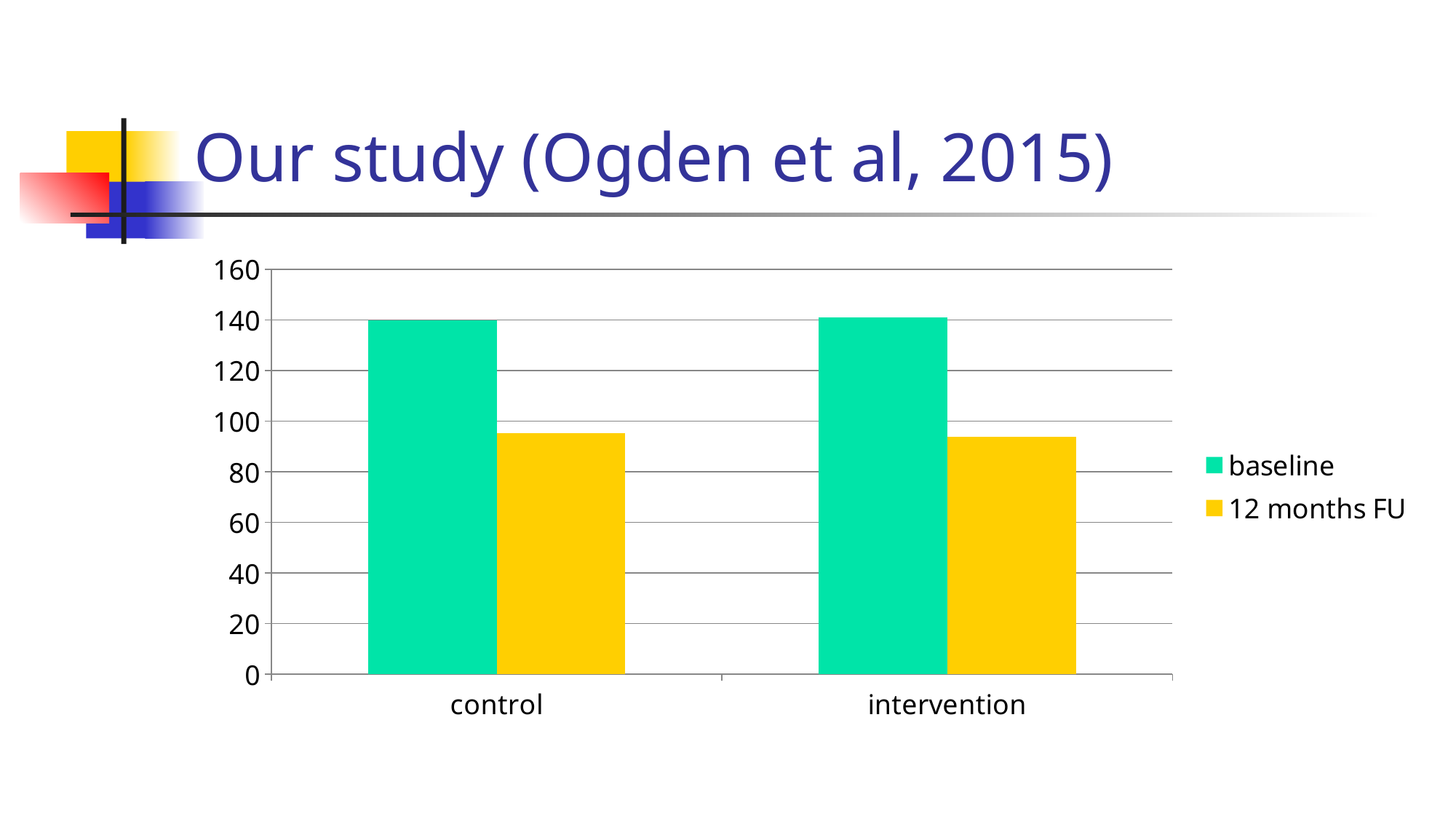
For the control group, which is larger: the baseline value or the 12 months FU value? baseline Which colour represents the 12 months FU series in the chart? yellow What kind of chart is shown on the slide? bar chart For the intervention group, which is larger: the baseline value or the 12 months FU value? baseline Is the 12 months FU value for the intervention group greater or less than 100? less How many categories are shown on the x axis of the chart? 2 Is the 12 months FU value for the control group greater or less than 80? greater Is the baseline value for the intervention group greater or less than 120? greater What is the baseline value for the control group? 140 What are the two series listed in the chart's legend? baseline and 12 months FU How many series does the chart's legend list? 2